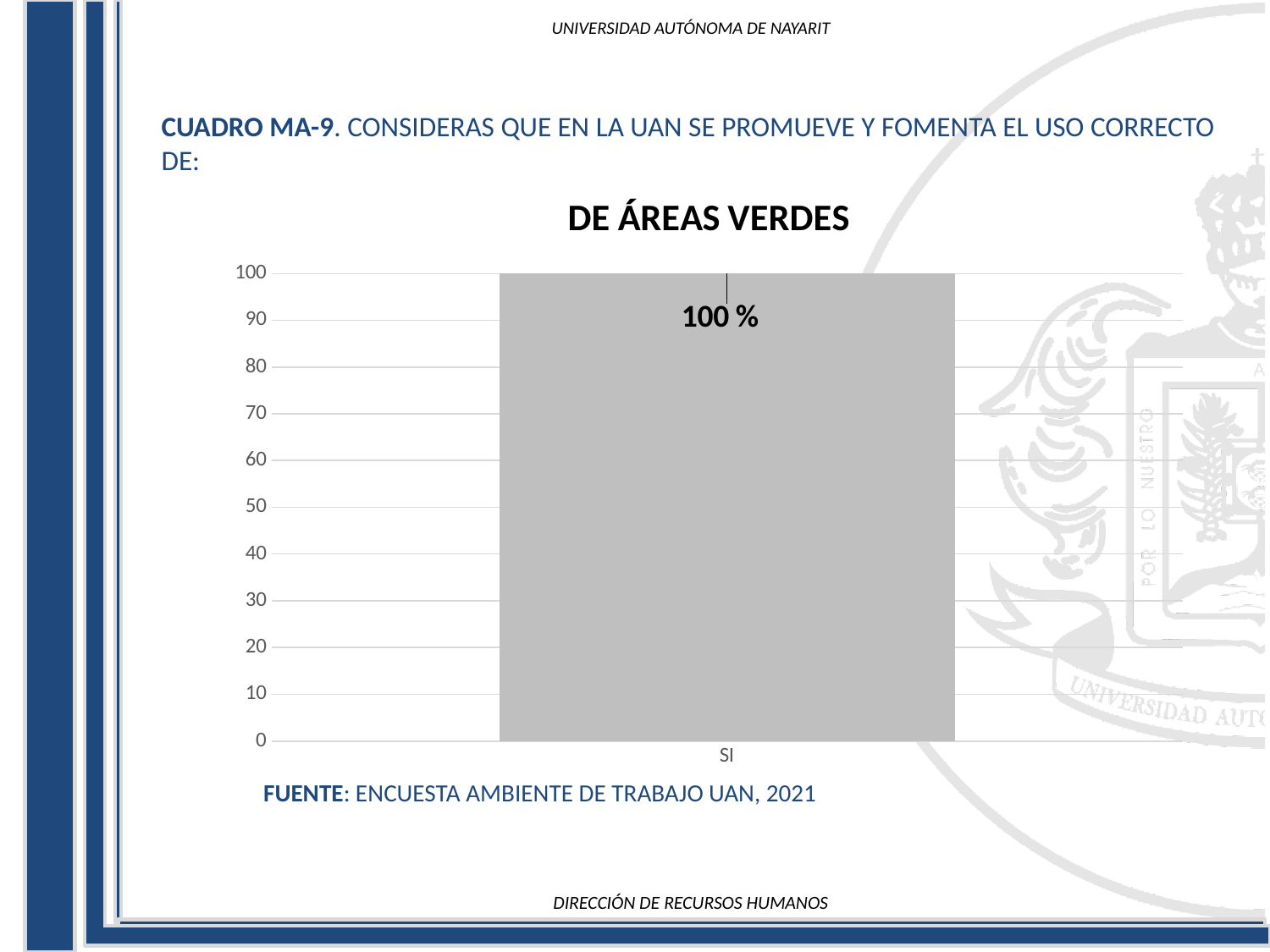
Which category has the highest value? SI What is the title of the chart? DE ÁREAS VERDES What is the highest value shown on the vertical axis? 100 Is the value for SI greater or less than 50? greater What kind of chart is shown on the slide? bar chart What is the label of the only category on the x axis? SI How many categories are plotted on the x axis? 1 What is the value shown for the SI category? 100 %